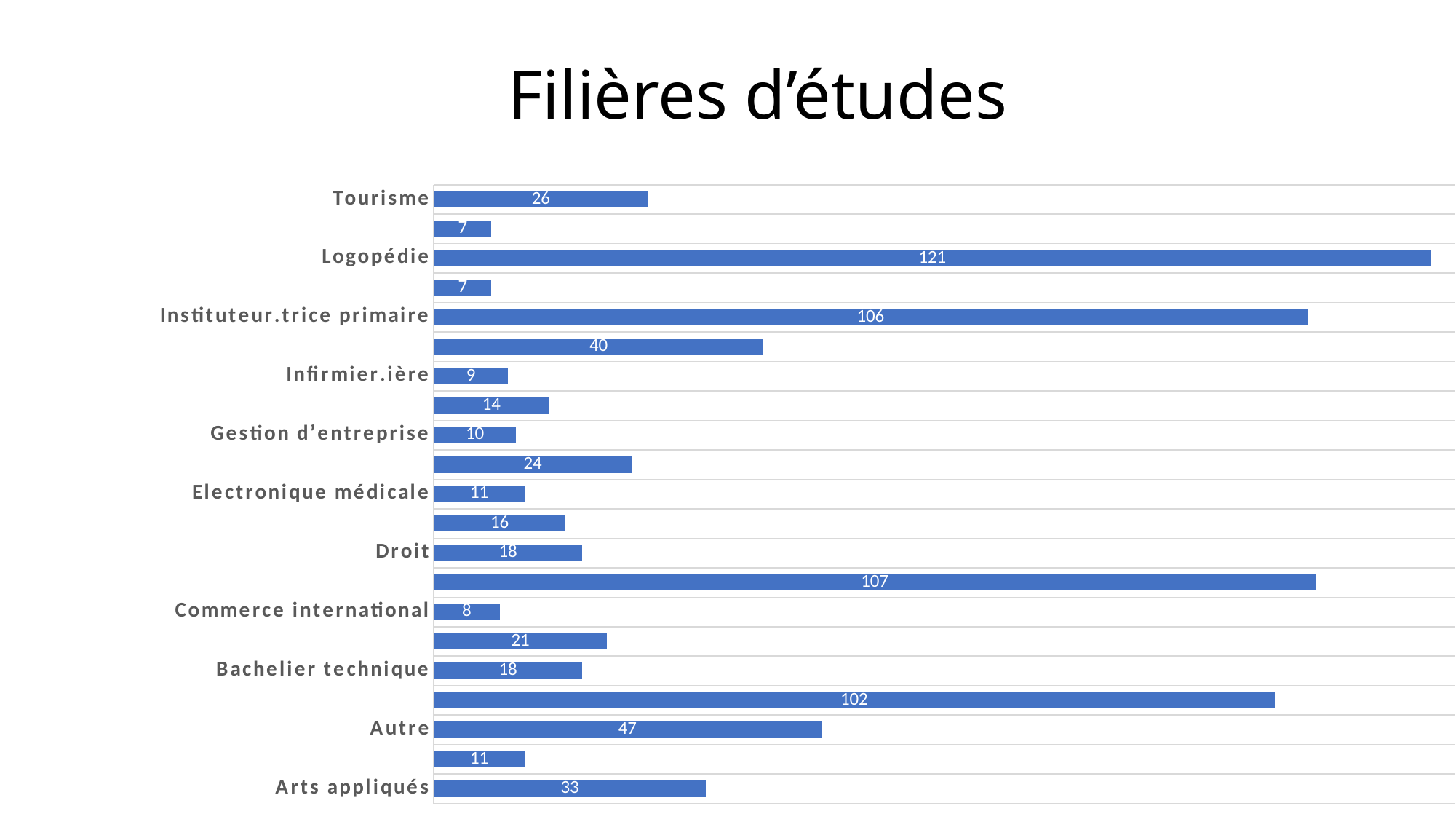
What is the value for Logopédie? 121 What is the value for Autre? 47 Which is larger, the value for Autre or the value for Arts appliqués? Autre Which labelled category has the highest value? Logopédie What is the title of the slide? Filières d’études What is the value for Arts appliqués? 33 What is the value for Tourisme? 26 How many bars are plotted in the chart? 21 What is the difference between the values for Autre and Tourisme? 21 What kind of chart is shown on the slide? Bar chart What is the value for Commerce international? 8 What is the difference between the values for Logopédie and Instituteur.trice primaire? 15